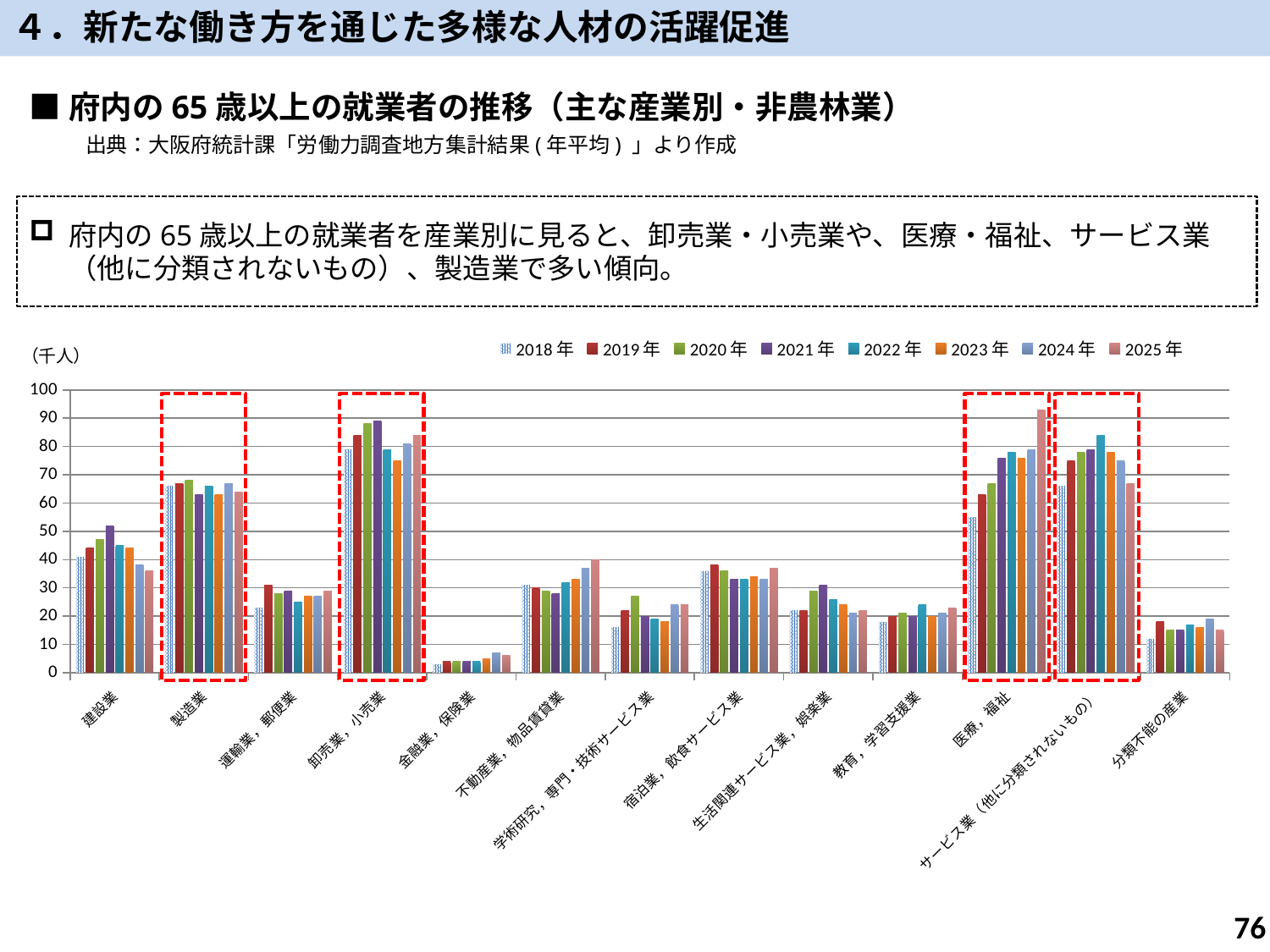
What unit is shown at the top of the y axis? 千人 Which is larger in 2018年: 建設業 or 製造業? 製造業 Is the value for 分類不能の産業 in 2018年 greater or less than 20? less Do the values for 医療，福祉 rise or fall from 2018年 to 2025年? rise Is the value for 卸売業，小売業 in 2021年 greater or less than 80? greater How many series does the legend list? 8 Is the value for 医療，福祉 in 2025年 greater or less than 80? greater How many industry categories are shown on the x axis? 13 What kind of chart is shown on the slide? bar chart Which industry category has the lowest values across all years? 金融業，保険業